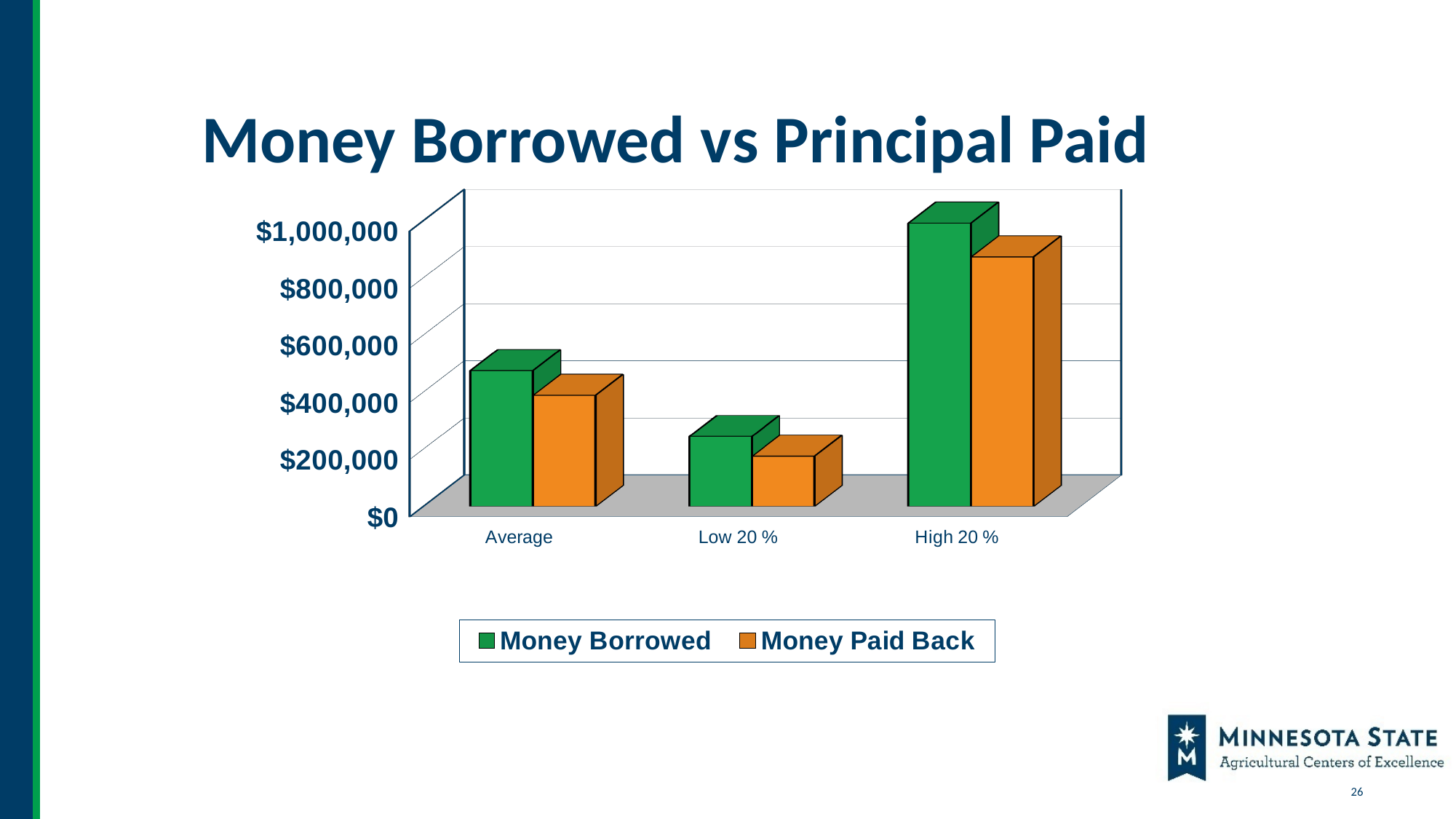
What type of chart is shown on the slide? bar chart How many series does the legend list? 2 Which colour represents the Money Paid Back series in the legend? orange Is the Money Paid Back value for High 20 % greater or less than $800,000? greater Is the Money Borrowed value for Average greater or less than $400,000? greater Which category has the lowest Money Paid Back value? Low 20 % Is the Money Borrowed value for Low 20 % greater or less than $400,000? less For the Average category, which is larger: Money Borrowed or Money Paid Back? Money Borrowed Which category has the highest Money Borrowed value? High 20 % How many categories are shown on the x axis? 3 What is the title of the chart? Money Borrowed vs Principal Paid